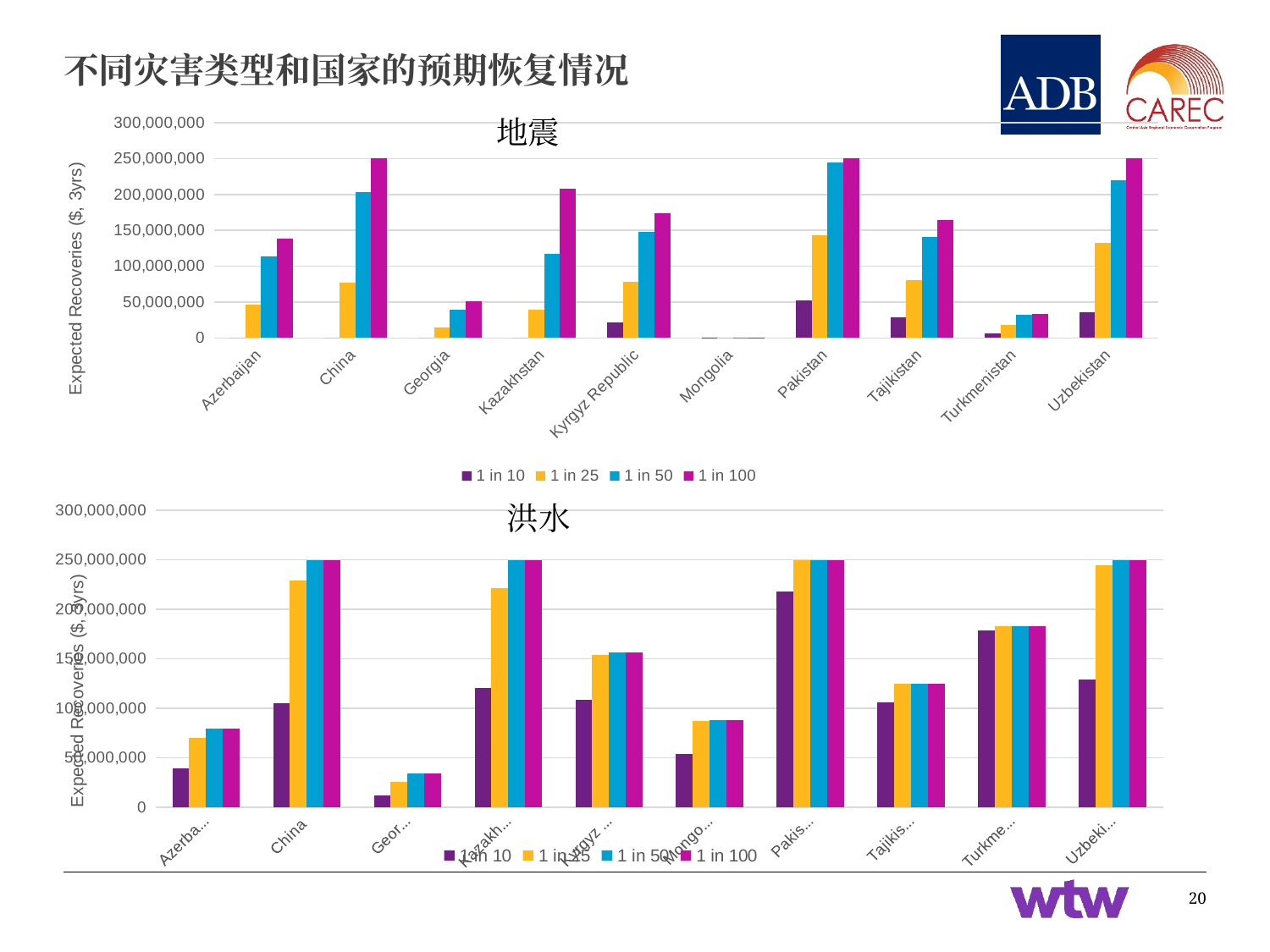
In the bottom chart (洪水), how many series does the legend list? 4 In the top chart (地震), which has the larger 1 in 25 value, Pakistan or Tajikistan? Pakistan In the top chart (地震), is the 1 in 100 value for Azerbaijan greater or less than 100,000,000? greater In the top chart (地震), which country has the lowest 1 in 100 value? Mongolia In the top chart (地震), how many countries are shown on the x axis? 10 In the top chart (地震), which has the larger 1 in 100 value, Kazakhstan or Kyrgyz Republic? Kazakhstan What is the y-axis label of the top chart (地震)? Expected Recoveries ($, 3yrs) In the bottom chart (洪水), is the 1 in 25 value for China greater or less than 200,000,000? greater In the top chart (地震), is the 1 in 50 value for China greater or less than 150,000,000? greater In the top chart (地震), how many series does the legend list? 4 What kind of chart is the top chart titled 地震? bar chart